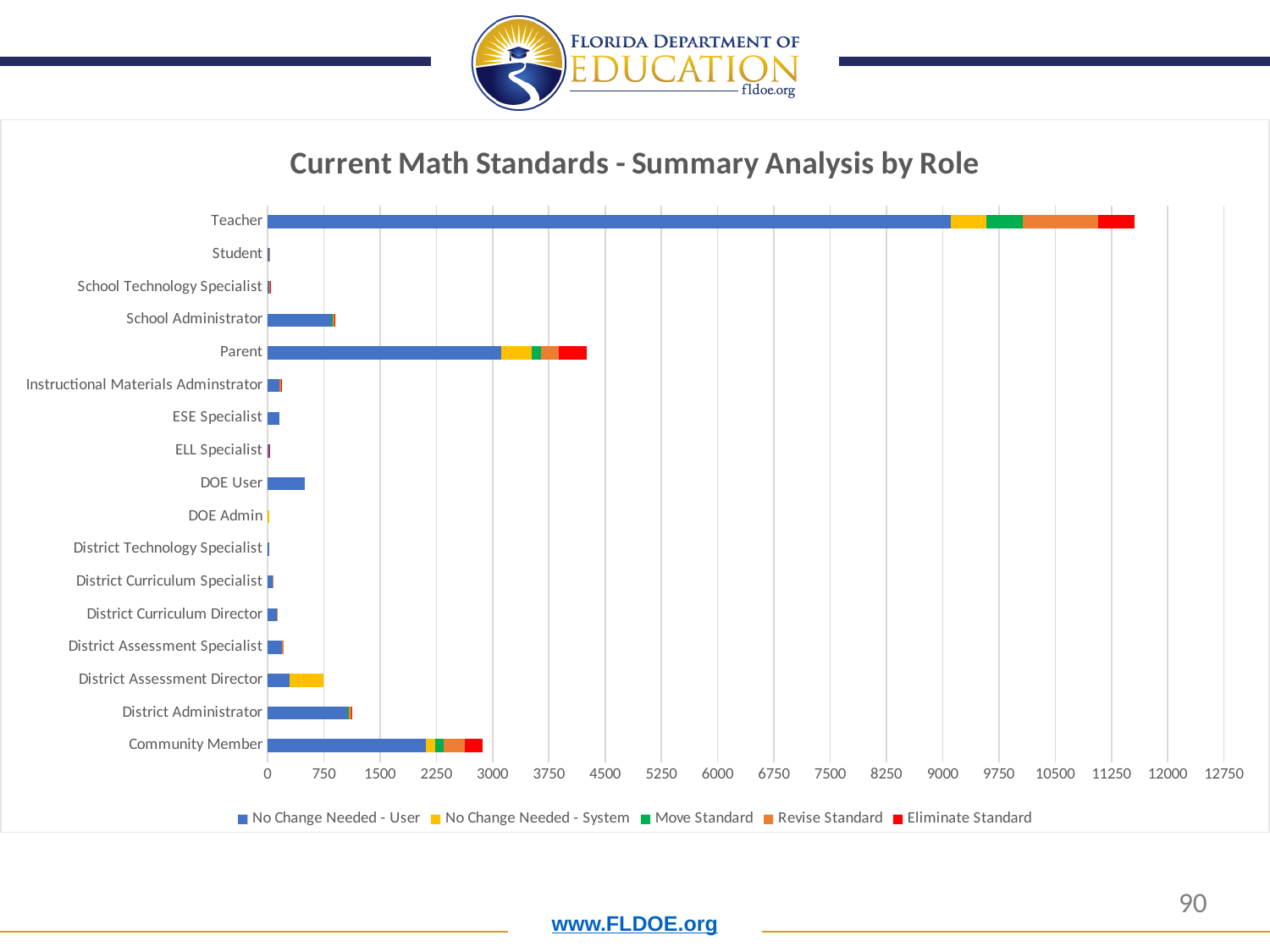
Which role has the longest total bar? Teacher Which has the longer total bar, Parent or Community Member? Parent Is the total bar for DOE User greater or less than 750? less Is the total bar for Teacher greater or less than 10500? greater Which colour represents the Eliminate Standard series in the legend? Red How many roles (categories) are plotted on the chart? 17 Is the total bar for Parent greater or less than 3750? greater What is the title of the chart? Current Math Standards - Summary Analysis by Role How many series does the legend list? 5 What kind of chart is shown on the slide? Stacked bar chart Which has the longer total bar, School Administrator or DOE User? School Administrator